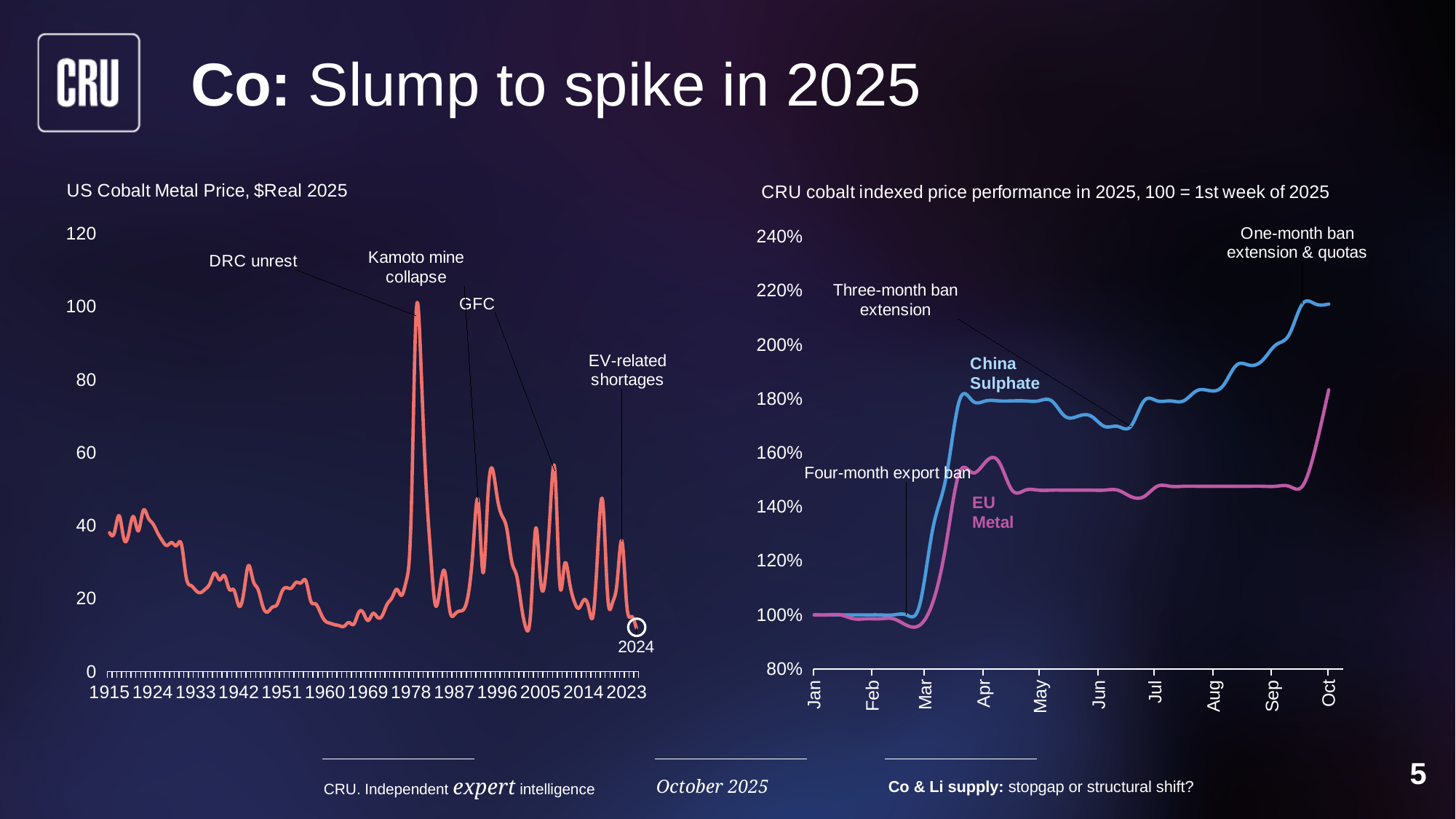
What kind of chart is the 'US Cobalt Metal Price, $Real 2025' chart on the left? line chart How many series are plotted on the 'CRU cobalt indexed price performance in 2025' chart? 2 On the 'US Cobalt Metal Price, $Real 2025' chart, is the circled 2024 value greater or less than 20? less On the 'CRU cobalt indexed price performance in 2025' chart, is the EU Metal value in May greater or less than 160%? less On the 'US Cobalt Metal Price, $Real 2025' chart, which annotated event marks the highest peak of the line? Kamoto mine collapse On the 'CRU cobalt indexed price performance in 2025' chart, does the China Sulphate series rise or fall between Jan and Apr? rise On the 'US Cobalt Metal Price, $Real 2025' chart, is the value at the 'Kamoto mine collapse' peak greater or less than 80? greater What kind of chart is the 'CRU cobalt indexed price performance in 2025' chart on the right? line chart On the 'CRU cobalt indexed price performance in 2025' chart, what colour is the China Sulphate line? blue On the 'CRU cobalt indexed price performance in 2025' chart, which series is higher in Oct, China Sulphate or EU Metal? China Sulphate